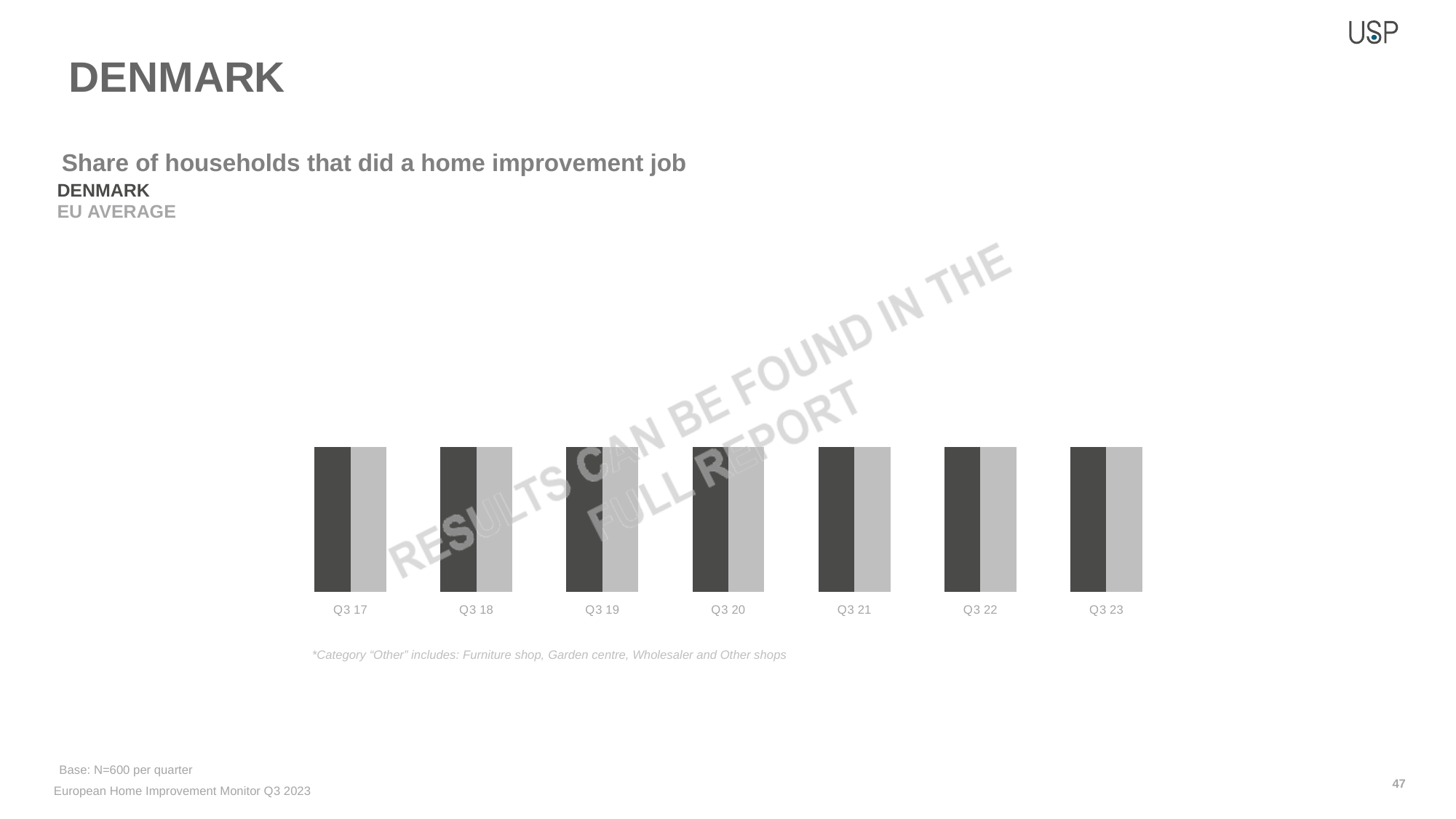
What kind of chart is shown on the slide? bar chart What is the label of the last category on the x axis? Q3 23 What is the title of the chart? Share of households that did a home improvement job How many series does the chart's legend list? 2 What is the label of the first category on the x axis? Q3 17 How many quarters are shown on the x axis of the chart? 7 Which two series are listed in the chart's legend? DENMARK and EU AVERAGE